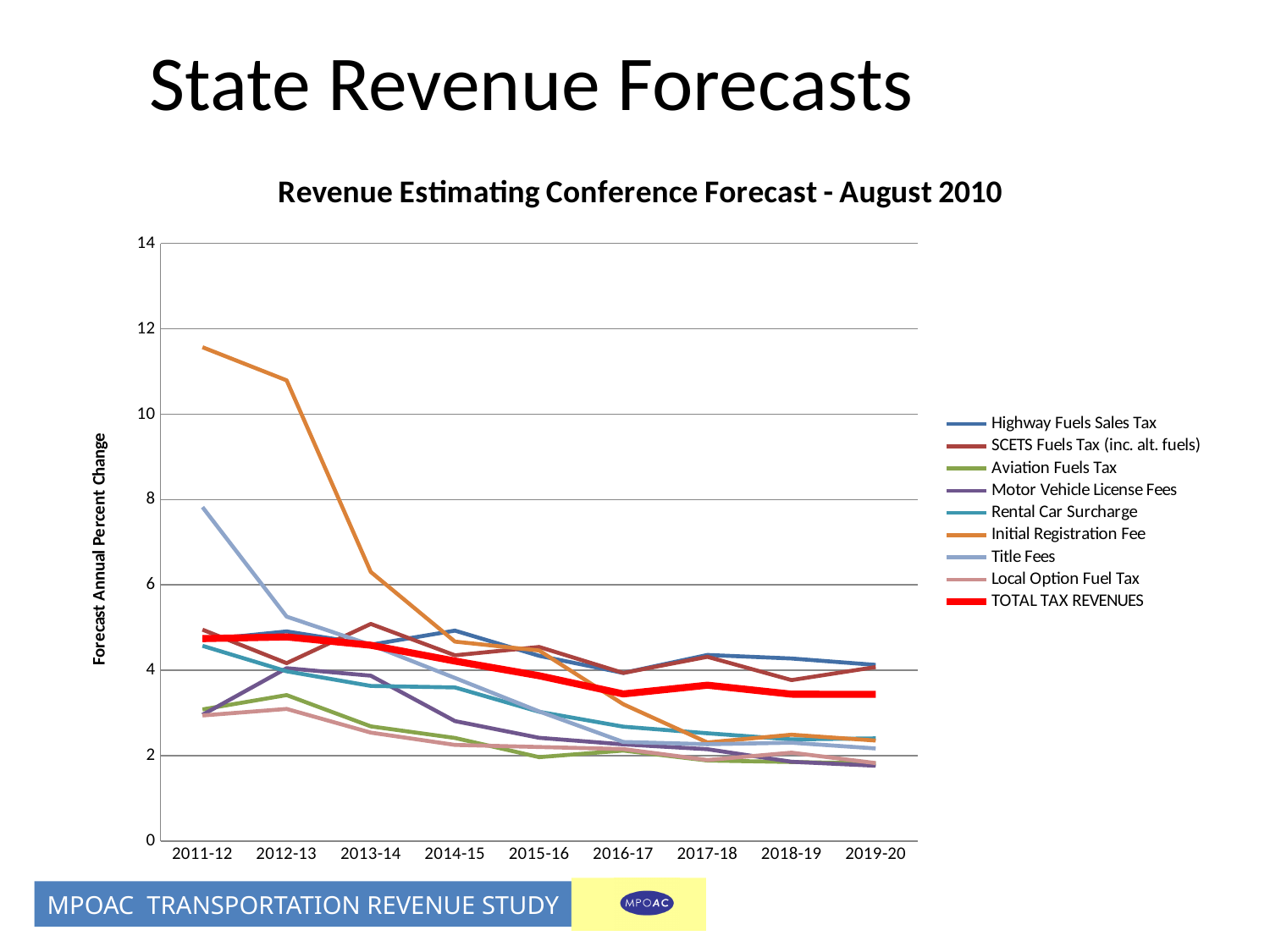
Is the value for TOTAL TAX REVENUES in 2019-20 greater or less than 4? less Does the Initial Registration Fee line rise or fall from 2011-12 to 2019-20? fall What is the title of the chart? Revenue Estimating Conference Forecast - August 2010 Is the value for Aviation Fuels Tax in 2011-12 greater or less than 4? less What is the label on the vertical axis? Forecast Annual Percent Change Is the value for Title Fees in 2011-12 greater or less than 6? greater Which series has the highest value in 2011-12? Initial Registration Fee In 2019-20, which is larger: Highway Fuels Sales Tax or Aviation Fuels Tax? Highway Fuels Sales Tax How many series does the legend list? 9 What kind of chart is shown on the slide? line chart How many fiscal years are shown along the x axis? 9